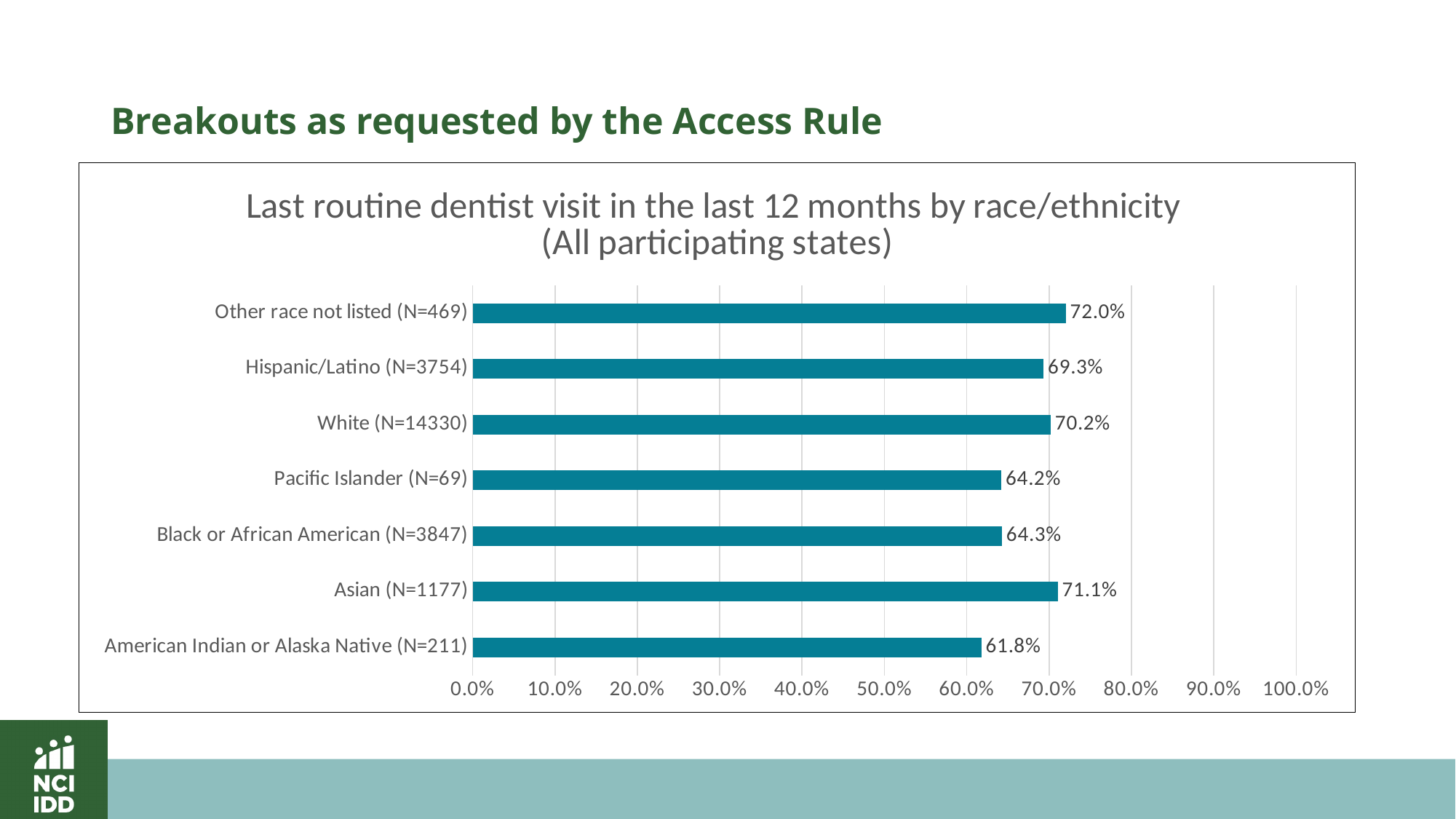
Is the value for Black or African American (N=3847) greater or less than 60.0%? greater What is the title of the chart? Last routine dentist visit in the last 12 months by race/ethnicity (All participating states) What is the value for Asian (N=1177)? 71.1% Which is larger, the value for Asian (N=1177) or the value for Pacific Islander (N=69)? Asian (N=1177) What is the value for American Indian or Alaska Native (N=211)? 61.8% What kind of chart is shown on the slide? Bar chart What is the difference between the values for White (N=14330) and Hispanic/Latino (N=3754)? 0.9% How many categories are shown in the chart? 7 Which category has the highest value? Other race not listed (N=469) What is the difference between the values for Other race not listed (N=469) and American Indian or Alaska Native (N=211)? 10.2% Which category has the lowest value? American Indian or Alaska Native (N=211) What is the value for White (N=14330)? 70.2%